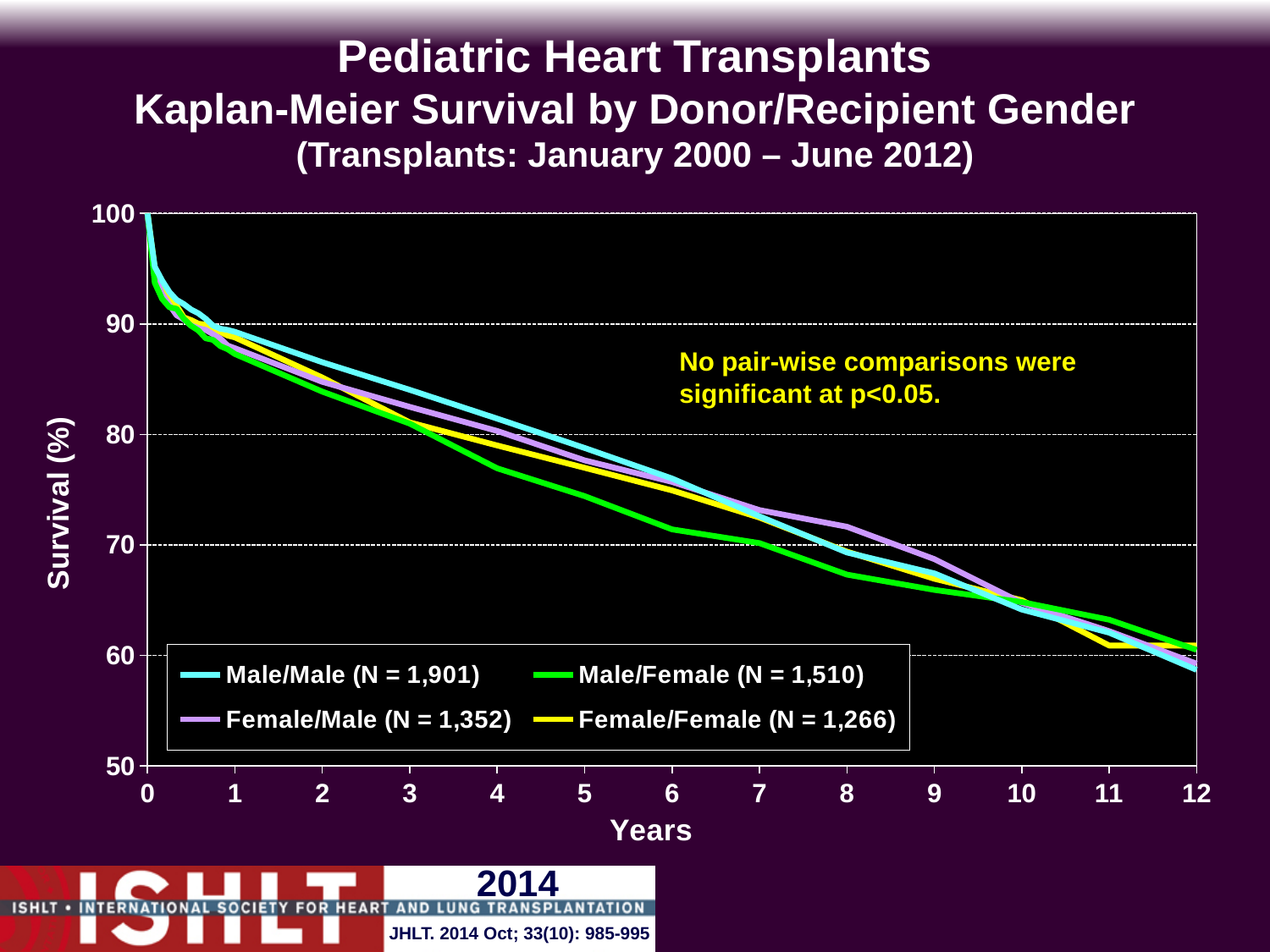
What is the N shown in the legend for the Male/Male series? 1,901 At year 4, which series has the highest survival? Male/Male Is the survival value for Male/Male at year 2 greater or less than 80? greater At year 8, which is higher: the survival for Female/Male or for Male/Female? Female/Male Is the survival value for Male/Female at year 4 greater or less than 80? less Is the survival value for Male/Female at year 8 greater or less than 70? less How many series does the legend list? 4 What is the label of the y axis? Survival (%) What kind of chart is shown on the slide? line chart At year 4, which series has the lowest survival? Male/Female Do the survival curves rise or fall as the years increase along the x axis? fall